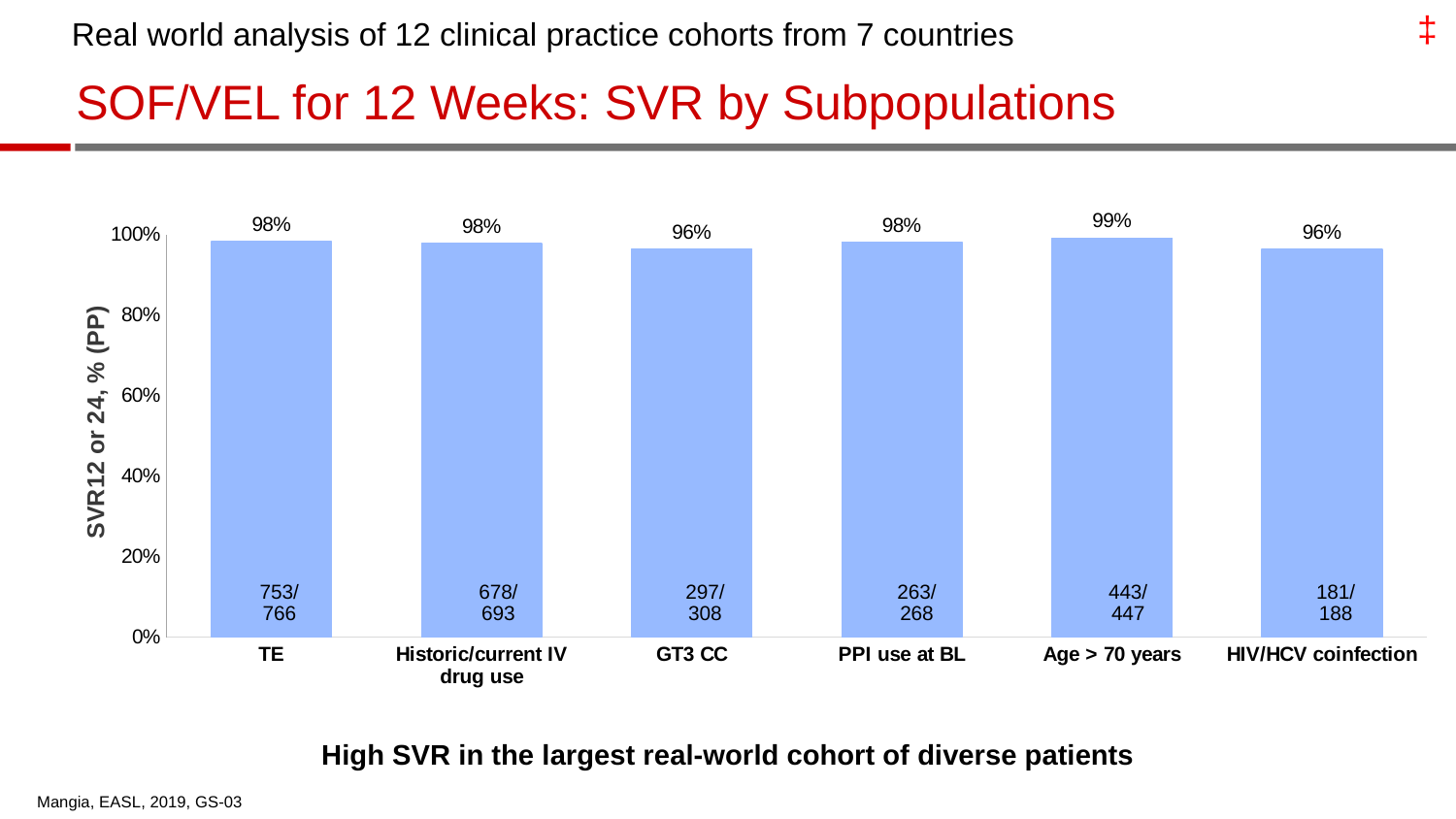
What is the label of the y-axis? SVR12 or 24, % (PP) What is the SVR rate for the TE subpopulation? 98% What is the difference in SVR rate between the Age > 70 years and GT3 CC subpopulations? 3% What type of chart is shown on the slide? Bar chart Which subpopulation has the highest SVR rate? Age > 70 years What is the SVR rate for the GT3 CC subpopulation? 96% Which has a higher SVR rate, PPI use at BL or HIV/HCV coinfection? PPI use at BL What is the SVR rate for patients aged > 70 years? 99% What is the SVR rate for the HIV/HCV coinfection subpopulation? 96% How many subpopulations are shown in the chart? 6 How many patients achieved SVR out of how many in the Historic/current IV drug use subpopulation? 678/693 Is the SVR rate for PPI use at BL greater or less than 80%? greater